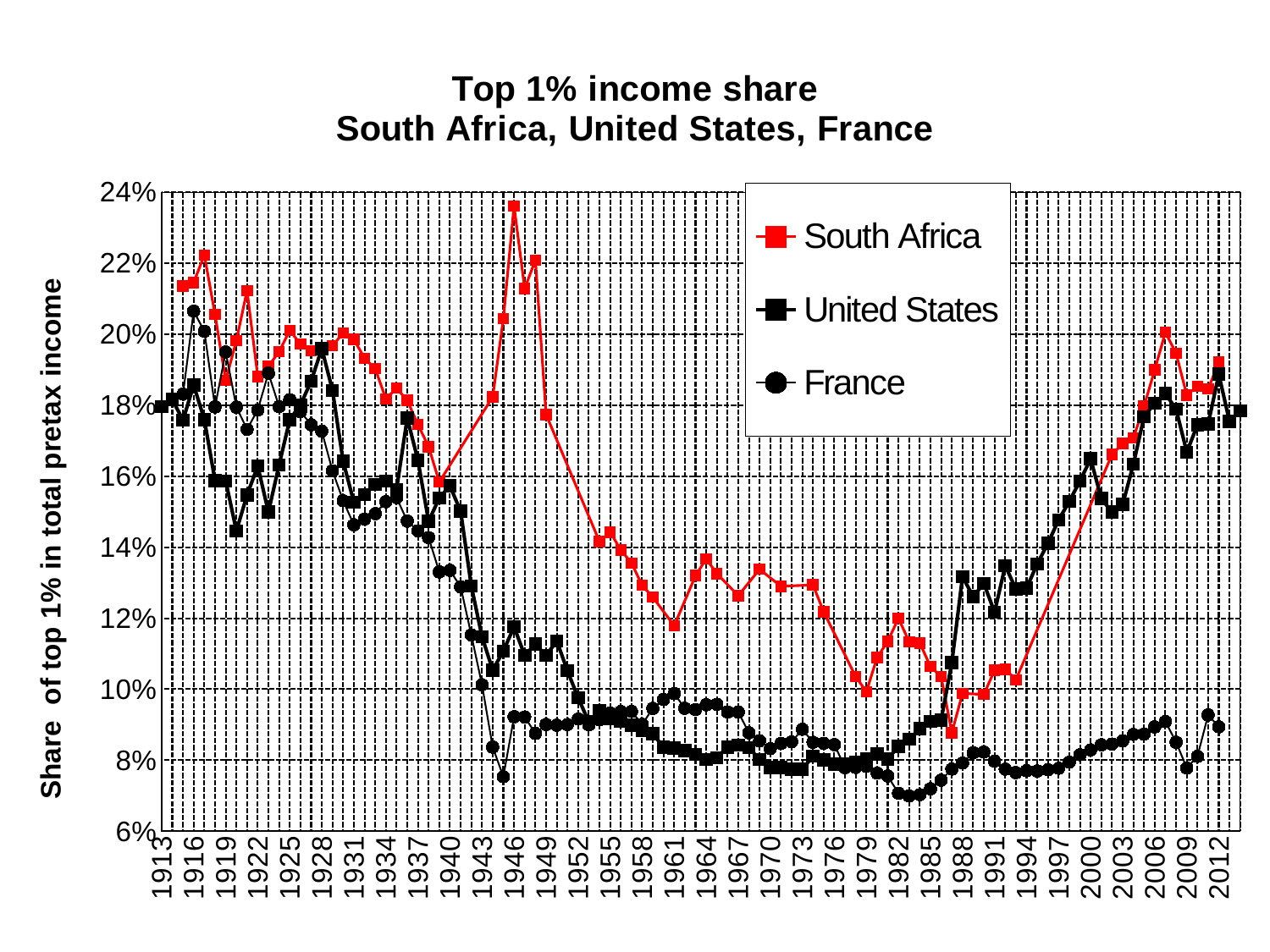
Is the value for South Africa in 1946 greater or less than 22%? greater What is the title of the chart? Top 1% income share South Africa, United States, France Which series has the lowest value in 2000? France In 1982, which is larger: the value for the United States or the value for France? United States In 1946, which is larger: the value for South Africa or the value for the United States? South Africa Is the value for France in 1982 greater or less than 8%? less How many series does the legend list? 3 Is the value for the United States in 1976 greater or less than 10%? less What kind of chart is shown on the slide? line chart Does the South Africa series rise or fall between 1949 and 1979? fall Which series is drawn in red? South Africa